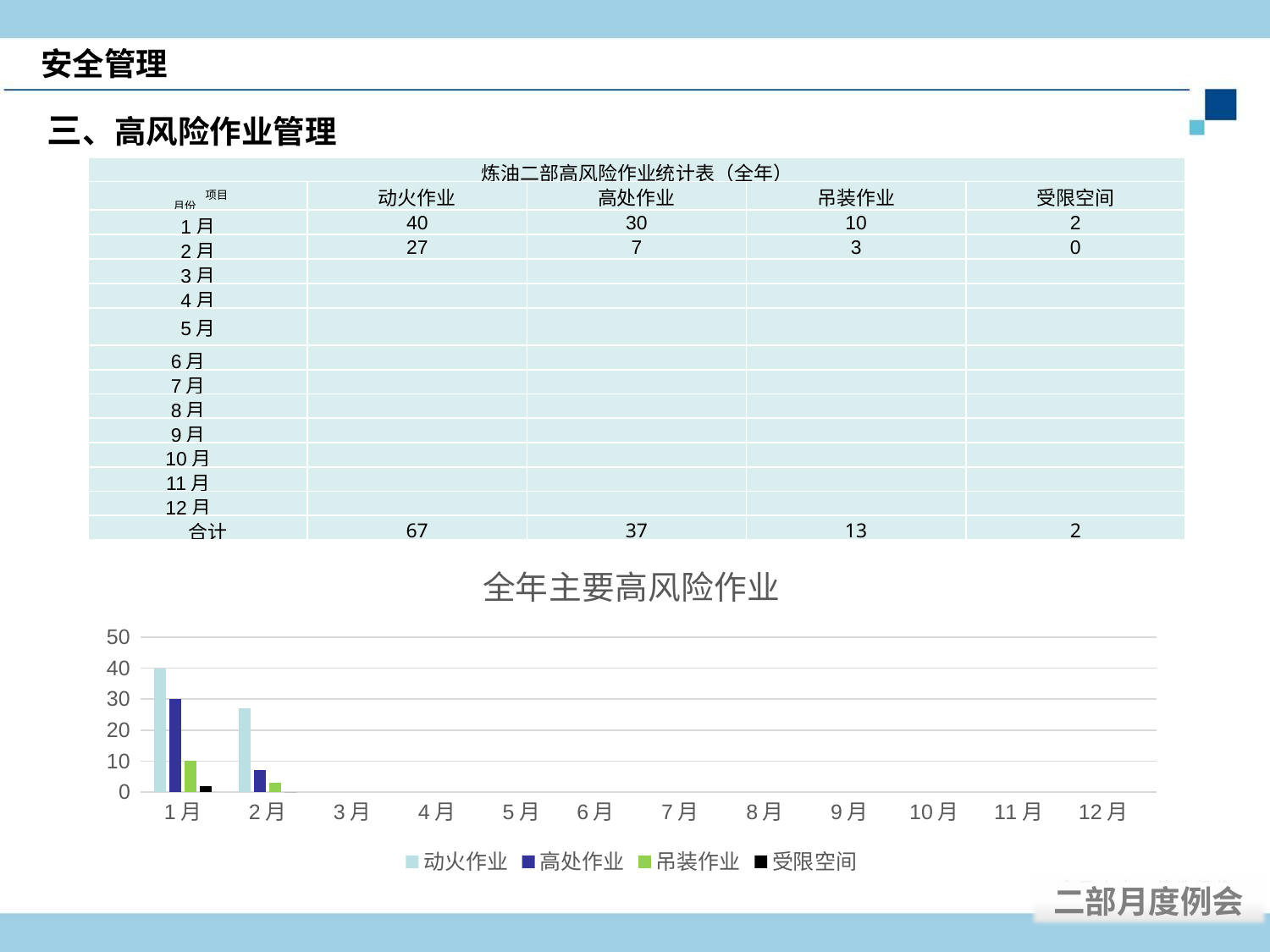
How many month categories are shown on the x axis of the 全年主要高风险作业 chart? 12 In the 全年主要高风险作业 chart, does the value for 动火作业 rise or fall from 1月 to 2月? fall In the 全年主要高风险作业 chart, what is the value for 吊装作业 in 1月? 10 How many series does the legend of the 全年主要高风险作业 chart list? 4 In the 全年主要高风险作业 chart, what is the value for 高处作业 in 1月? 30 In the 全年主要高风险作业 chart, which series has the highest value in 1月? 动火作业 In the 全年主要高风险作业 chart, is the value for 动火作业 in 2月 greater or less than 30? less In the 全年主要高风险作业 chart, what is the value for 动火作业 in 1月? 40 What kind of chart is shown under the title 全年主要高风险作业? bar chart In the 全年主要高风险作业 chart, is the value for 高处作业 in 2月 greater or less than 10? less In the 全年主要高风险作业 chart, which is larger in 1月: 动火作业 or 高处作业? 动火作业 In the 全年主要高风险作业 chart, what is the difference between 动火作业 and 高处作业 in 1月? 10